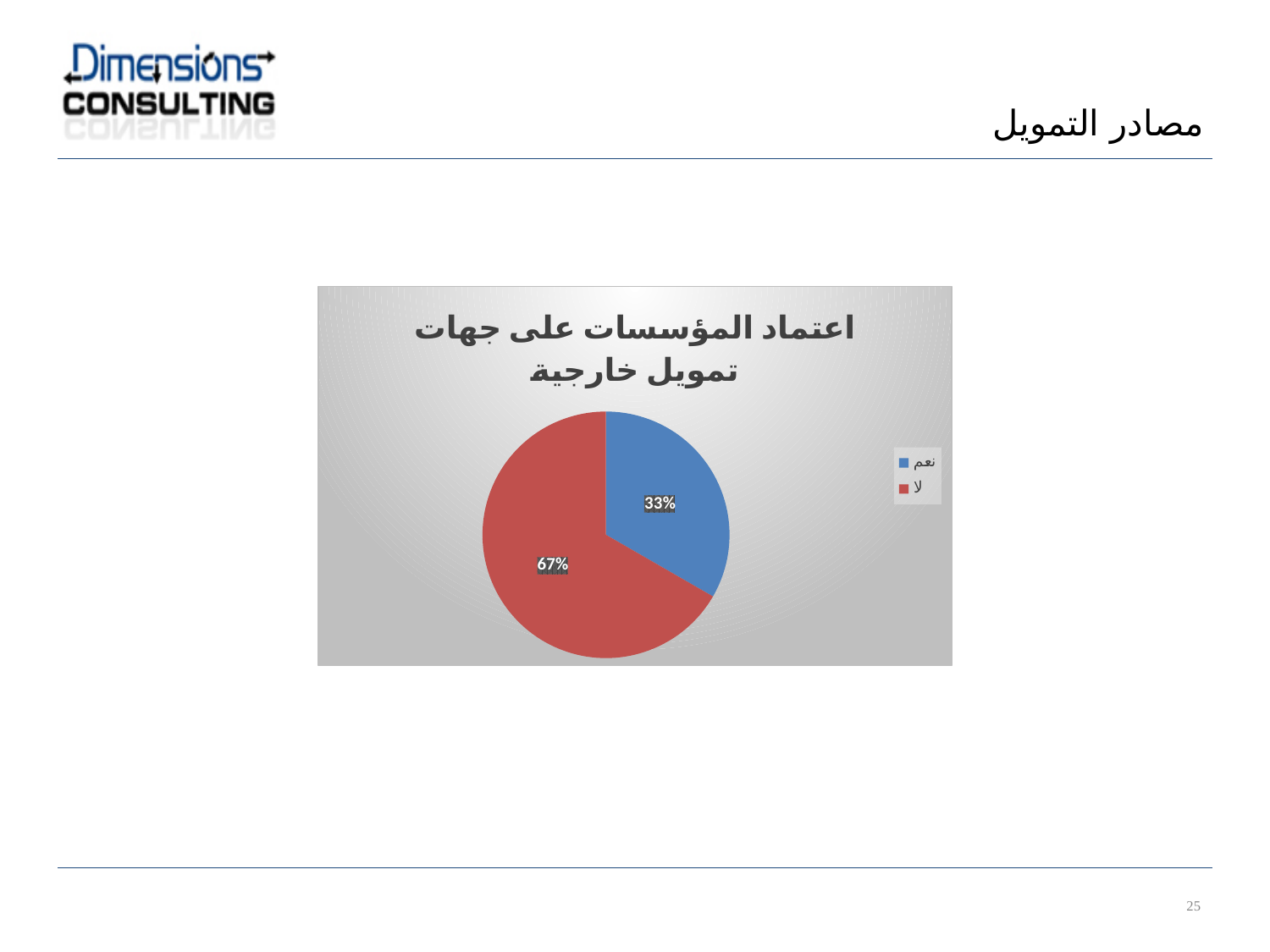
How many slices does the pie chart have? 2 What share of the pie does the نعم slice represent? 33% Which slice is the largest in the pie chart? لا Which is larger, the نعم slice or the لا slice? لا Which slice is the smallest in the pie chart? نعم What is the title of the chart? اعتماد المؤسسات على جهات تمويل خارجية What kind of chart is shown on the slide? pie chart What is the difference in percentage points between the لا slice and the نعم slice? 34 What colour is the نعم slice? blue What share of the pie does the لا slice represent? 67% How many entries does the legend list? 2 What is the value printed on the red slice? 67%